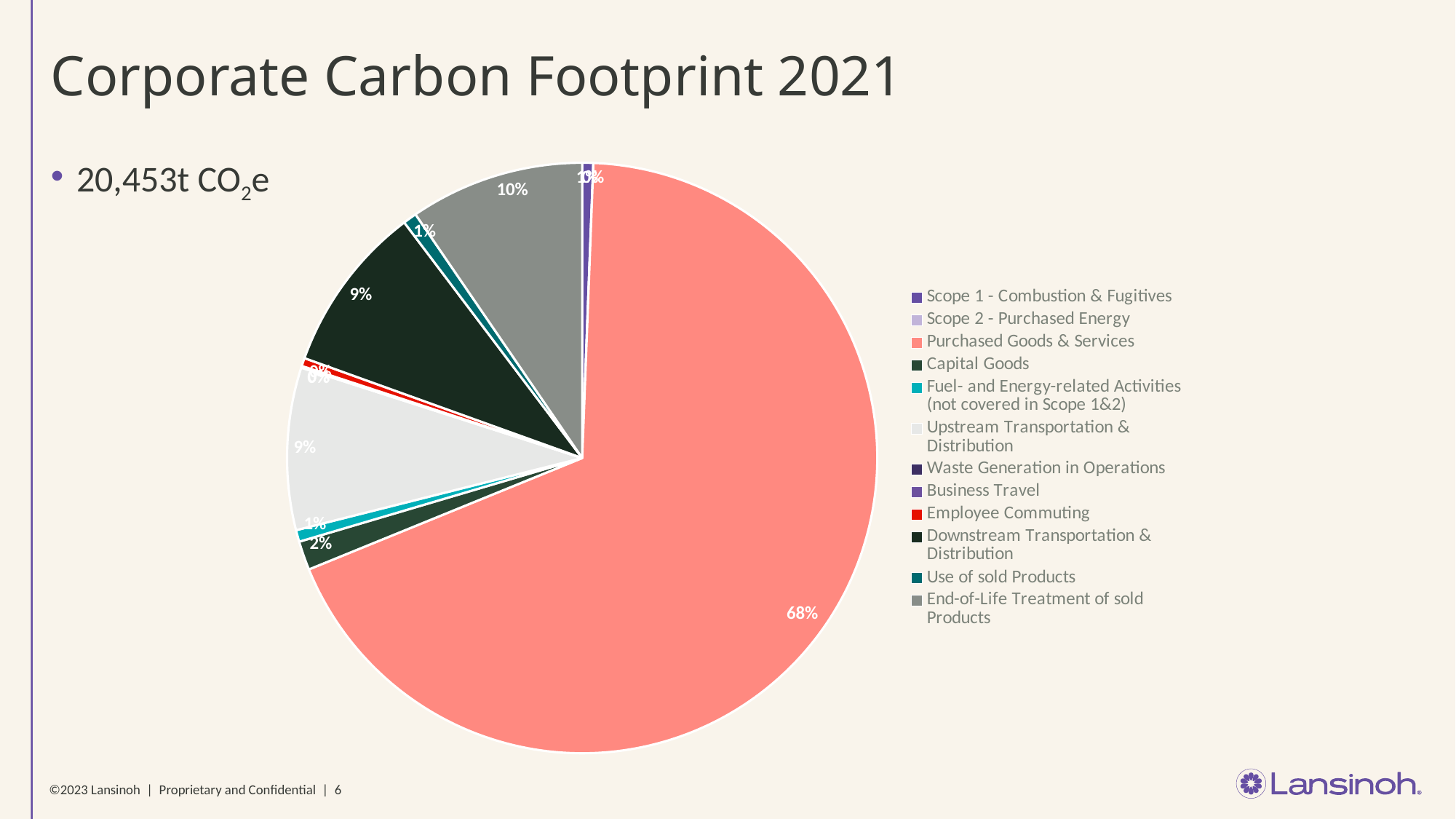
What share of the pie does Purchased Goods & Services account for? 68% What share of the pie does Downstream Transportation & Distribution account for? 9% What kind of chart is shown on the slide? pie chart What share of the pie does End-of-Life Treatment of sold Products account for? 10% How many categories does the legend list? 12 Which is larger, the share for End-of-Life Treatment of sold Products or the share for Capital Goods? End-of-Life Treatment of sold Products What is the difference in percentage points between the Purchased Goods & Services share and the End-of-Life Treatment of sold Products share? 58 Which category has the largest share of the pie? Purchased Goods & Services What is the title of the slide containing the pie chart? Corporate Carbon Footprint 2021